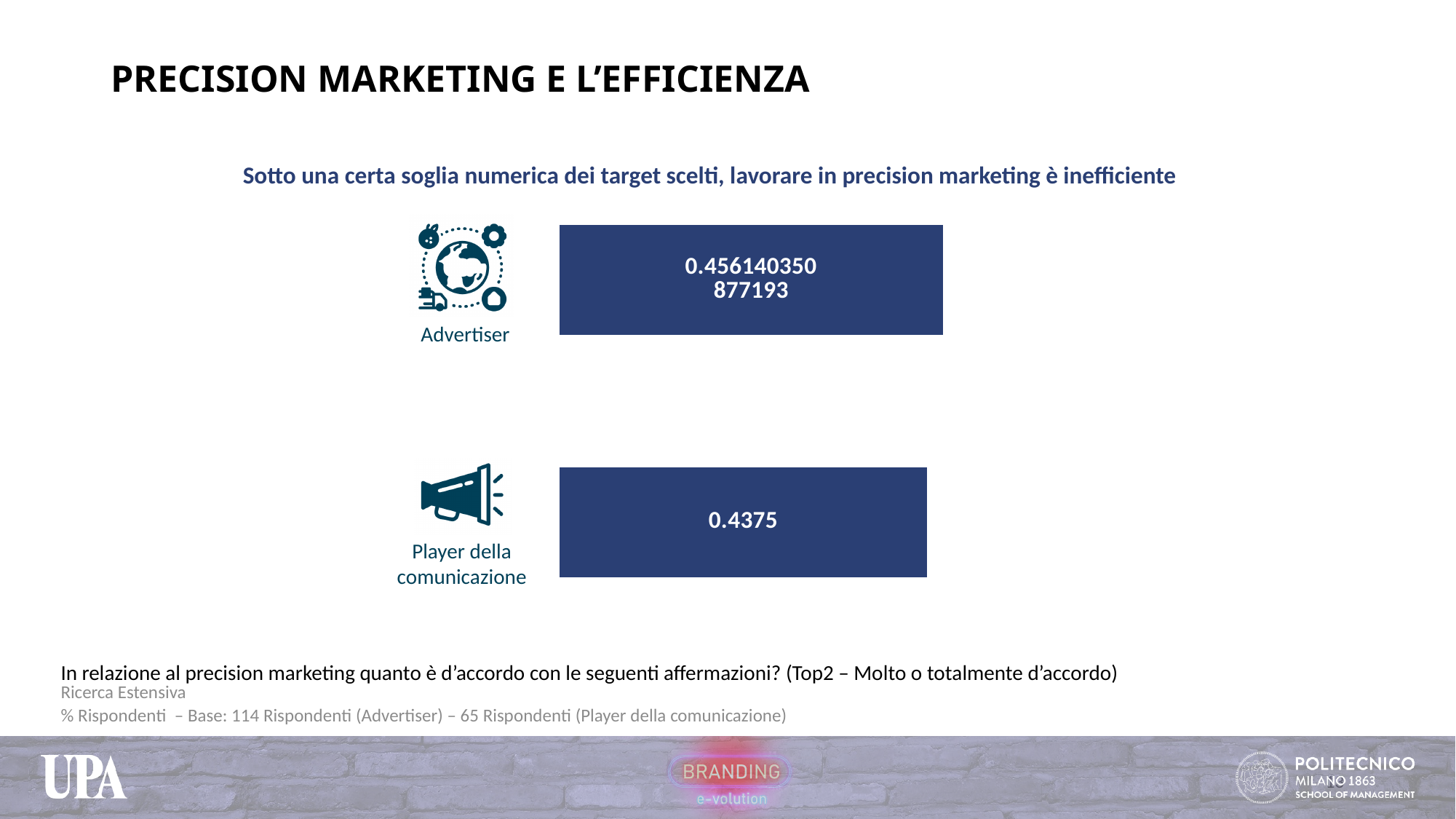
What is the base of respondents for Advertiser according to the note on the slide? 114 Rispondenti What kind of chart is shown on the slide? Bar chart What is the difference between the value for Advertiser and the value for Player della comunicazione? 0.018640350877193 What is the value shown for Advertiser? 0.456140350877193 Which is larger, the value for Advertiser or the value for Player della comunicazione? Advertiser What statement do the bars on the chart refer to? Sotto una certa soglia numerica dei target scelti, lavorare in precision marketing è inefficiente Which category has the highest value? Advertiser What is the value shown for Player della comunicazione? 0.4375 Which category has the lowest value? Player della comunicazione How many categories are shown in the chart? 2